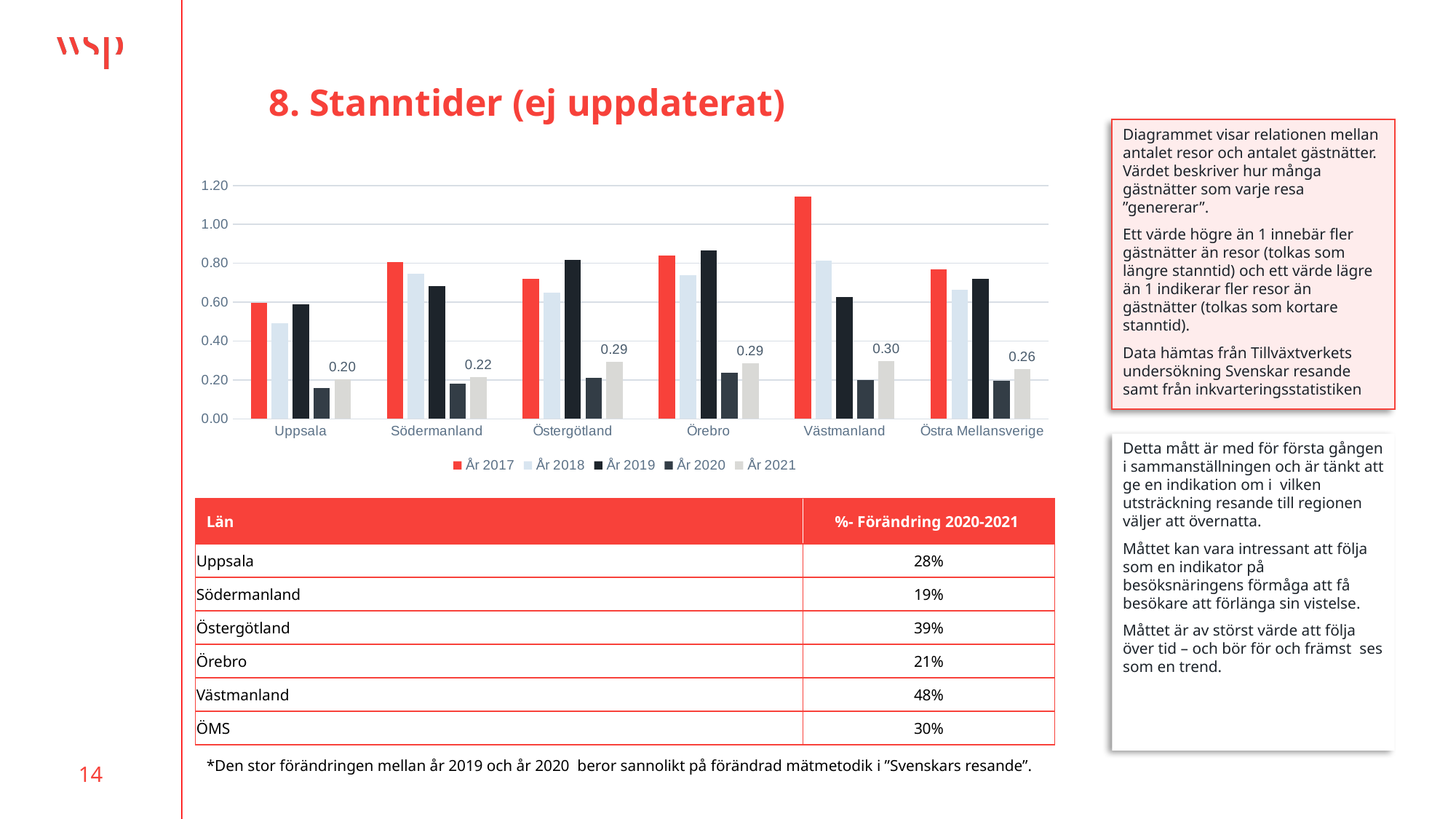
How many series does the chart's legend list? 5 Is the value for År 2018 in Uppsala greater or less than 0.60? less What kind of chart is shown on the slide? Bar chart Which category has the tallest bar for År 2017? Västmanland How many categories are shown on the x axis of the chart? 6 What is the value for År 2021 in Västmanland? 0.30 What is the value for År 2021 in Uppsala? 0.20 Which category has the highest value for År 2021? Västmanland What is the difference between the År 2021 values for Västmanland and Uppsala? 0.10 Which category has the lowest value for År 2021? Uppsala For År 2021, which is larger: Södermanland or Östra Mellansverige? Östra Mellansverige Is the value for År 2017 in Västmanland greater or less than 1.00? greater